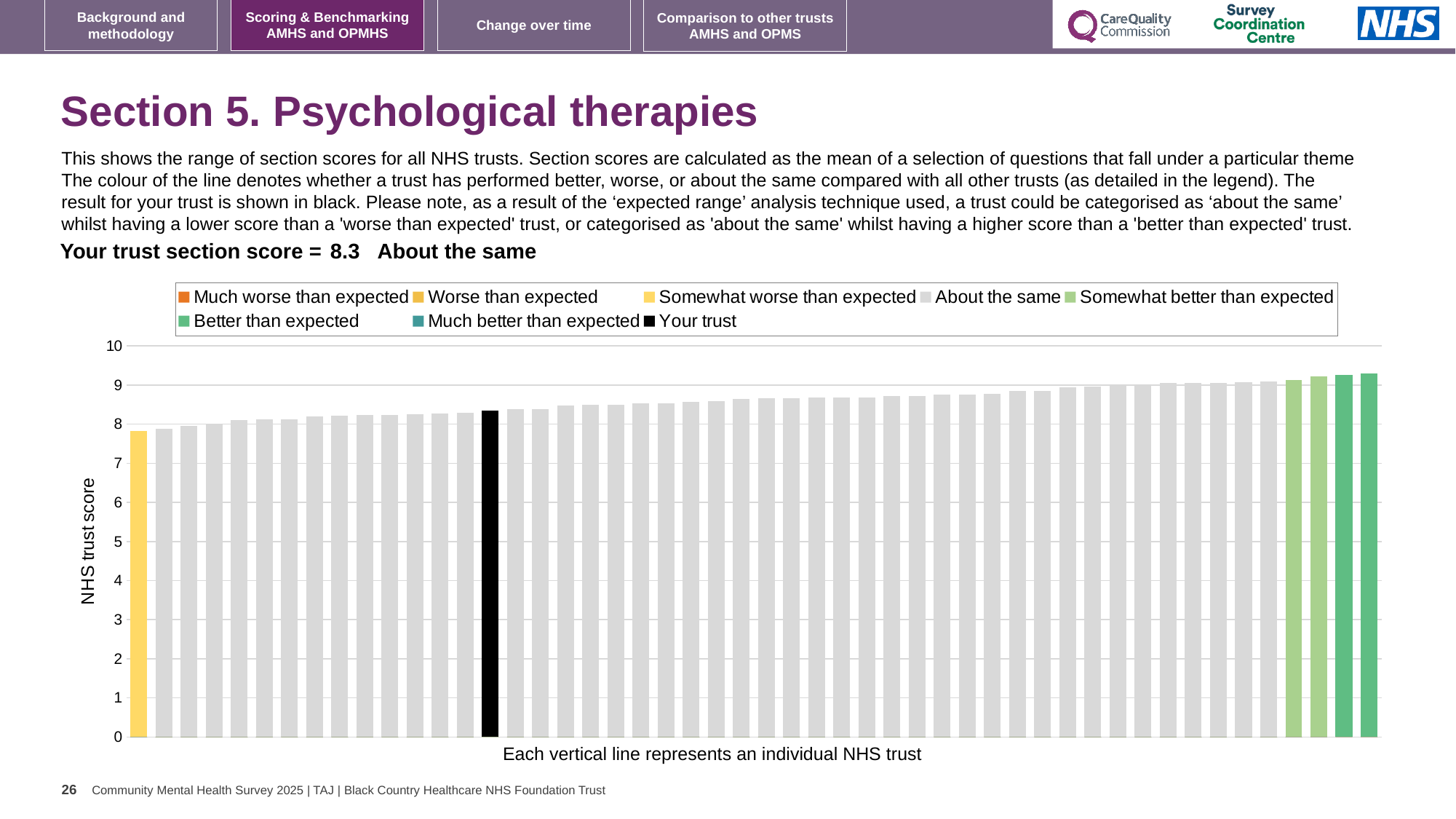
How is your trust categorised compared with other trusts in the Psychological therapies section? About the same What is your trust's section score for Psychological therapies? 8.3 What kind of chart is shown on the slide? Bar chart Which is larger: the value of the black bar (your trust) or the value of the leftmost yellow bar? The black bar (your trust) How many entries does the chart legend list? 8 Is the value of the lowest bar greater or less than 7? greater Do the bar values rise or fall from left to right along the x axis? Rise Is the value for your trust (the black bar) greater or less than 8? greater What colour is the bar representing your trust? Black Is the value of the highest bar greater or less than 9? greater What is the label on the vertical axis of the chart? NHS trust score What is the maximum value shown on the vertical axis? 10